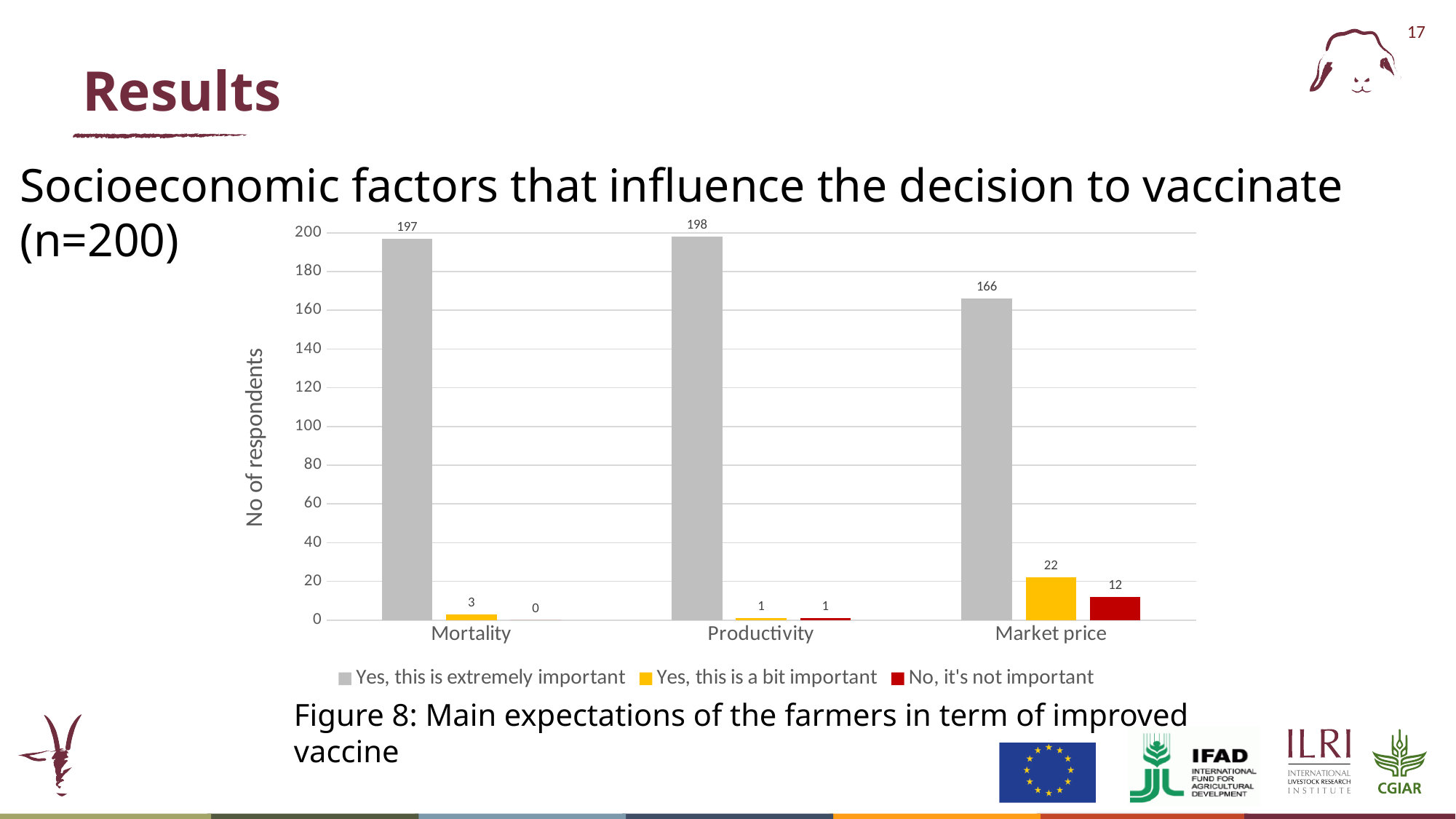
What is the difference between the number of respondents rating productivity as extremely important and those rating market price as extremely important? 32 Which category has the lowest number of respondents saying it is extremely important? Market price How many respondents said productivity is not important? 1 How many respondents said market price is a bit important? 22 How many categories are shown on the x axis? 3 How many series does the legend list? 3 How many respondents said market price is not important? 12 Which is larger: the number of respondents saying market price is a bit important or the number saying it is not important? A bit important (22) How many respondents said mortality is extremely important? 197 Which category has the highest number of respondents saying it is extremely important? Productivity What kind of chart is shown? Bar chart What is the label of the y axis? No of respondents